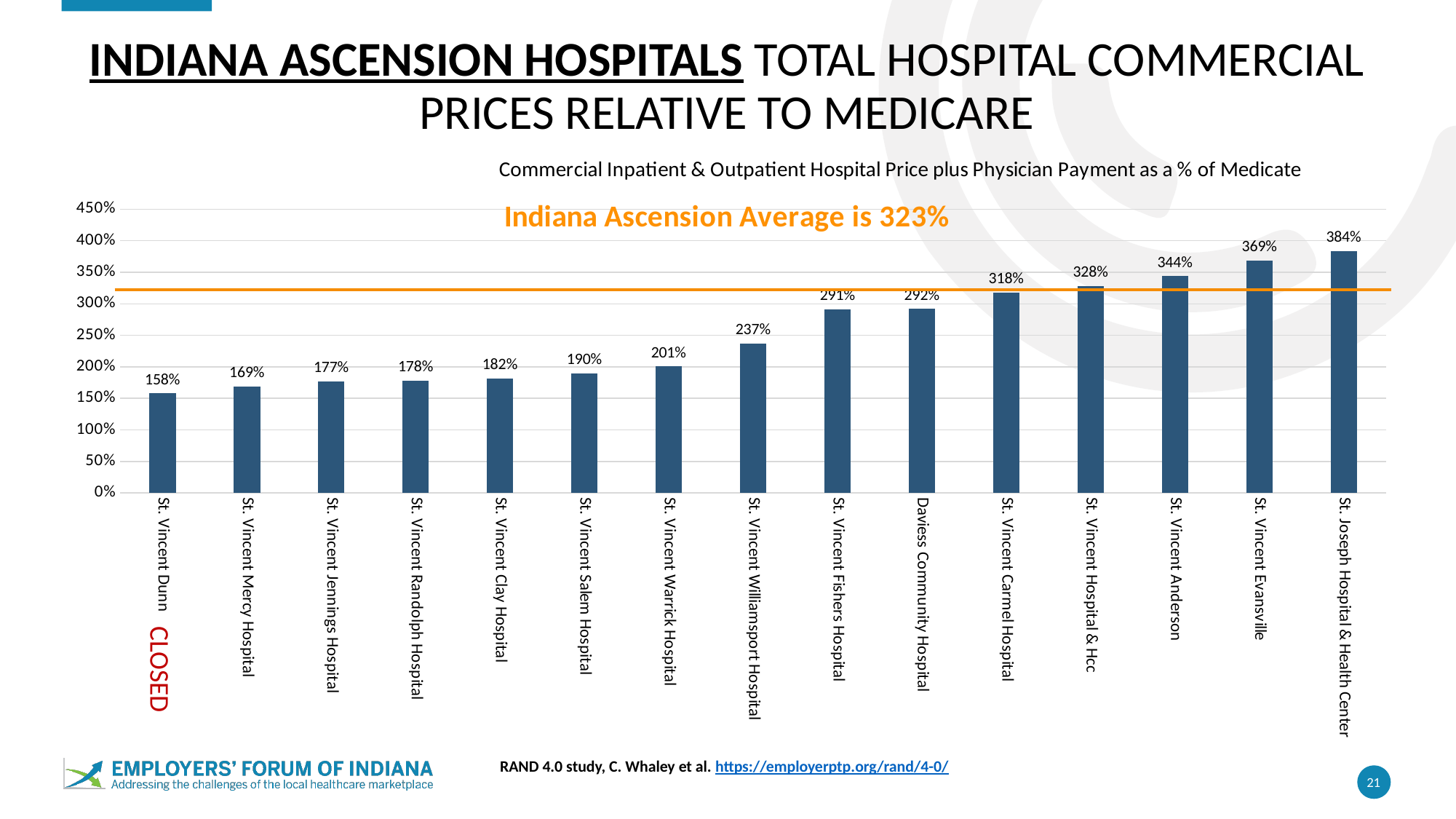
What is the value for St. Vincent Williamsport Hospital? 237% What kind of chart is shown on the slide? bar chart What is the value for St. Vincent Dunn? 158% Which hospital has the lowest value? St. Vincent Dunn Is the value for St. Vincent Fishers Hospital greater or less than 250%? greater What is the difference between St. Vincent Evansville and St. Vincent Anderson? 25% How many hospitals are shown in the chart? 15 Do the values rise or fall from left to right along the x axis? rise What is the Indiana Ascension average shown on the chart? 323% What is the value for Daviess Community Hospital? 292% Which hospital has the highest value? St. Joseph Hospital & Health Center Which is larger, the value for St. Vincent Carmel Hospital or St. Vincent Warrick Hospital? St. Vincent Carmel Hospital